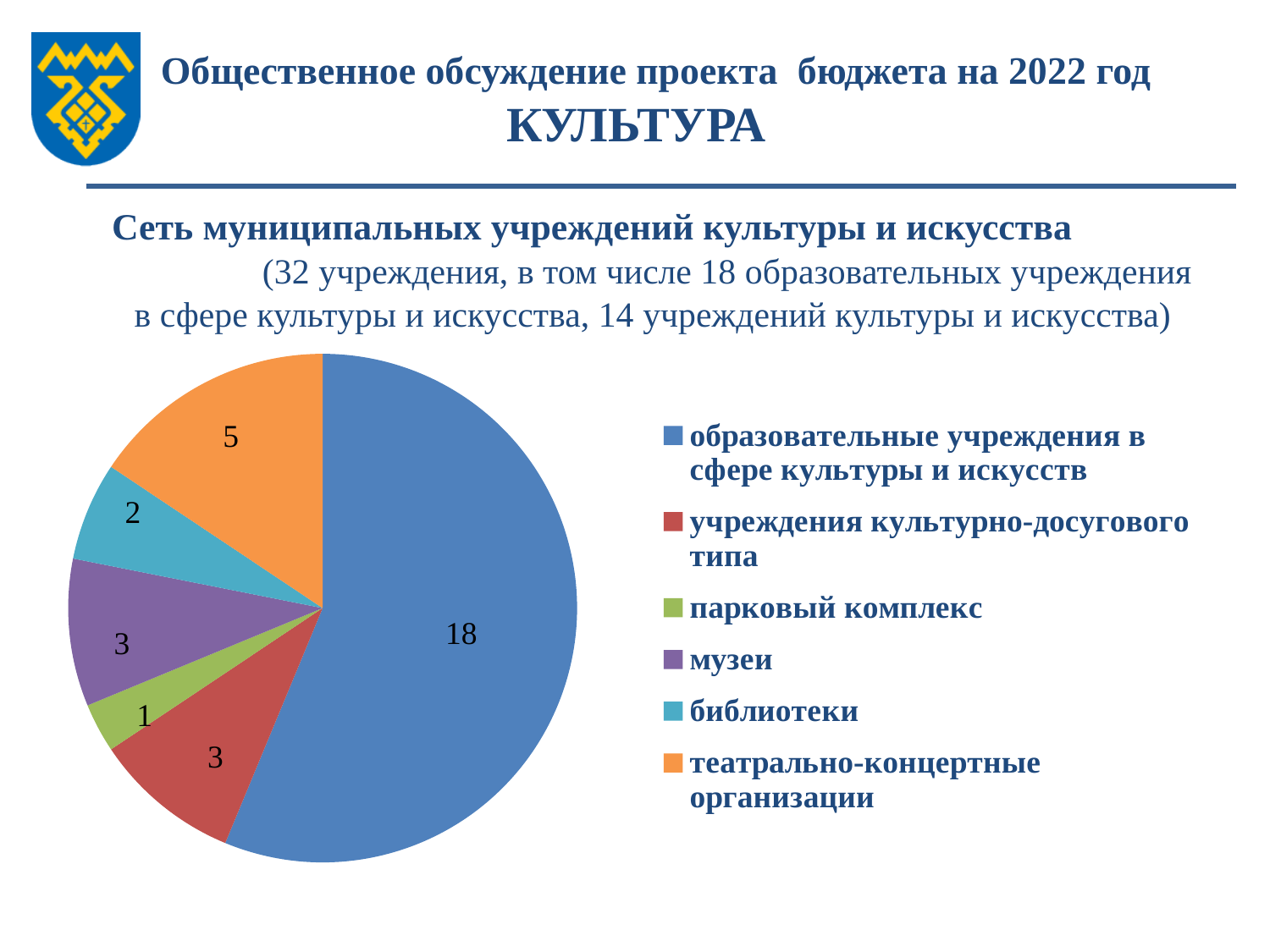
Which category has the largest slice of the pie? образовательные учреждения в сфере культуры и искусств What is the value for музеи? 3 What is the total of all slices in the pie chart? 32 What is the value for образовательные учреждения в сфере культуры и искусств? 18 How many slices does the pie chart have? 6 Which is larger: the value for библиотеки or the value for театрально-концертные организации? театрально-концертные организации What is the value for библиотеки? 2 Which category has the smallest slice of the pie? парковый комплекс What is the difference between the value for образовательные учреждения в сфере культуры и искусств and the value for театрально-концертные организации? 13 What share of the pie does the slice for парковый комплекс represent? 3.125% What type of chart is shown on the slide? pie chart What is the value for театрально-концертные организации? 5